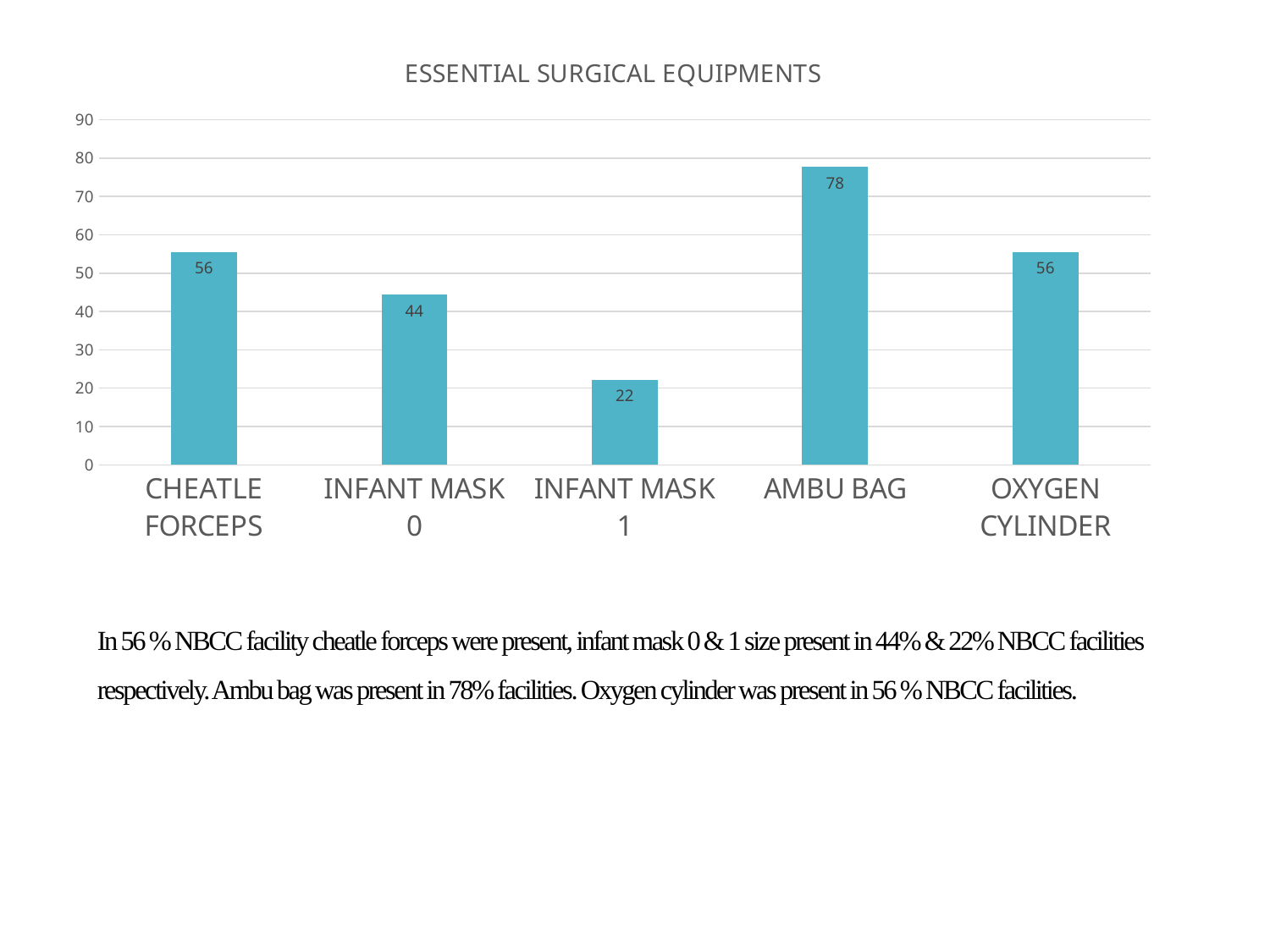
What is the value for INFANT MASK 0? 44 What is the title of the chart? ESSENTIAL SURGICAL EQUIPMENTS What kind of chart is shown on the slide? Bar chart How many categories are shown on the chart? 5 What is the difference between the values for INFANT MASK 0 and INFANT MASK 1? 22 What is the value for OXYGEN CYLINDER? 56 What is the difference between the values for AMBU BAG and INFANT MASK 1? 56 Which category has the lowest value? INFANT MASK 1 Which is larger, the value for CHEATLE FORCEPS or the value for INFANT MASK 0? CHEATLE FORCEPS Which category has the highest value? AMBU BAG What is the value for INFANT MASK 1? 22 What is the value for AMBU BAG? 78